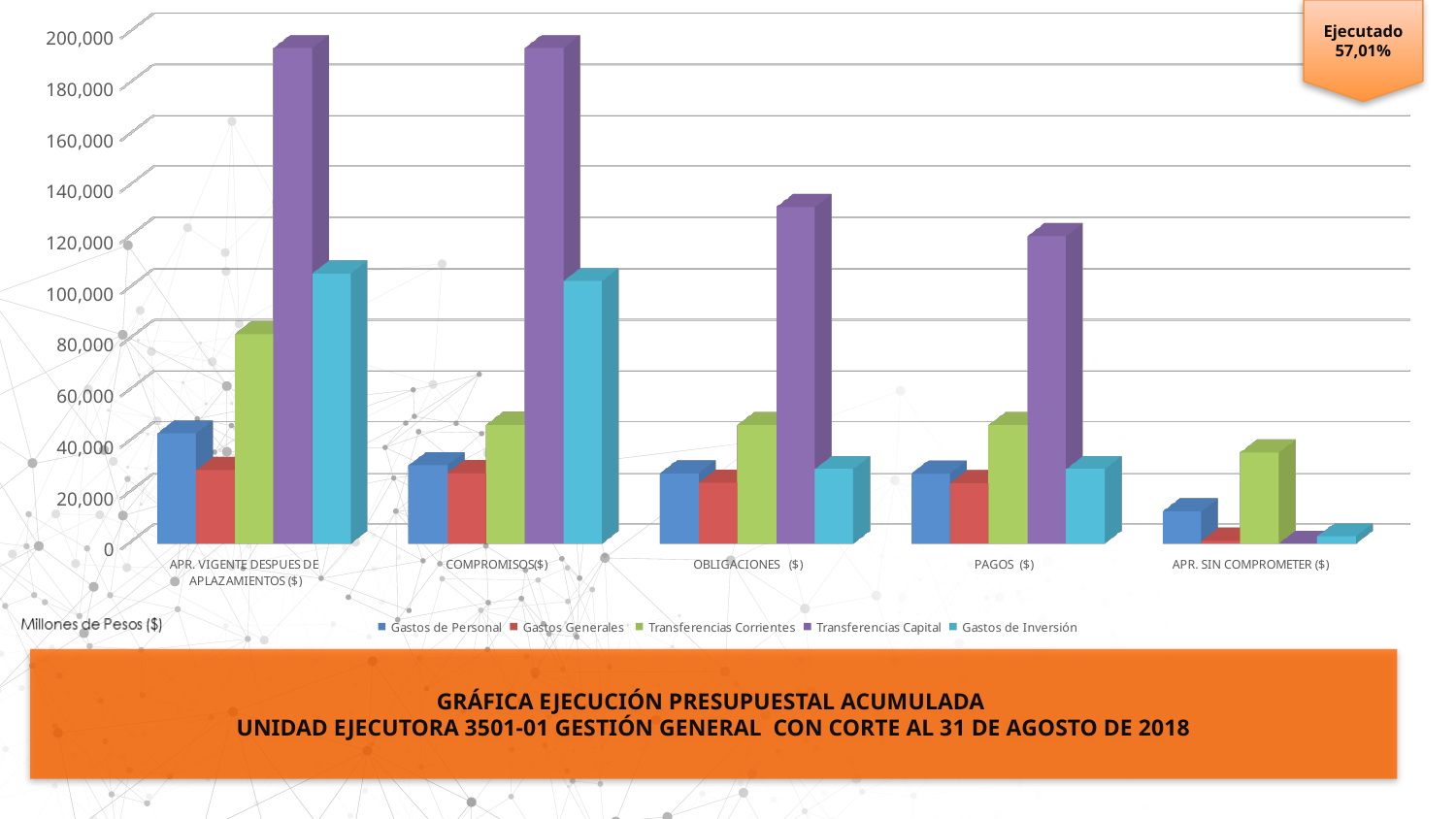
What kind of chart is shown on the slide? Bar chart In the COMPROMISOS($) category, which is larger: Gastos de Inversión or Transferencias Corrientes? Gastos de Inversión Is the value of Gastos Generales in APR. SIN COMPROMETER ($) greater or less than 20,000? less How many series does the chart legend list? 5 Is the value of Transferencias Capital in OBLIGACIONES ($) greater or less than 120,000? greater Is the value of Transferencias Capital in APR. VIGENTE DESPUES DE APLAZAMIENTOS ($) greater or less than 180,000? greater In which category is the Transferencias Corrientes bar the tallest? APR. VIGENTE DESPUES DE APLAZAMIENTOS ($) In the APR. VIGENTE DESPUES DE APLAZAMIENTOS ($) category, which is larger: Transferencias Corrientes or Gastos de Personal? Transferencias Corrientes Which series has the highest value in the PAGOS ($) category? Transferencias Capital How many categories are shown along the x axis of the chart? 5 Does the Transferencias Capital series rise or fall from COMPROMISOS($) to APR. SIN COMPROMETER ($)? Fall What colour represents the Transferencias Capital series in the chart? Purple